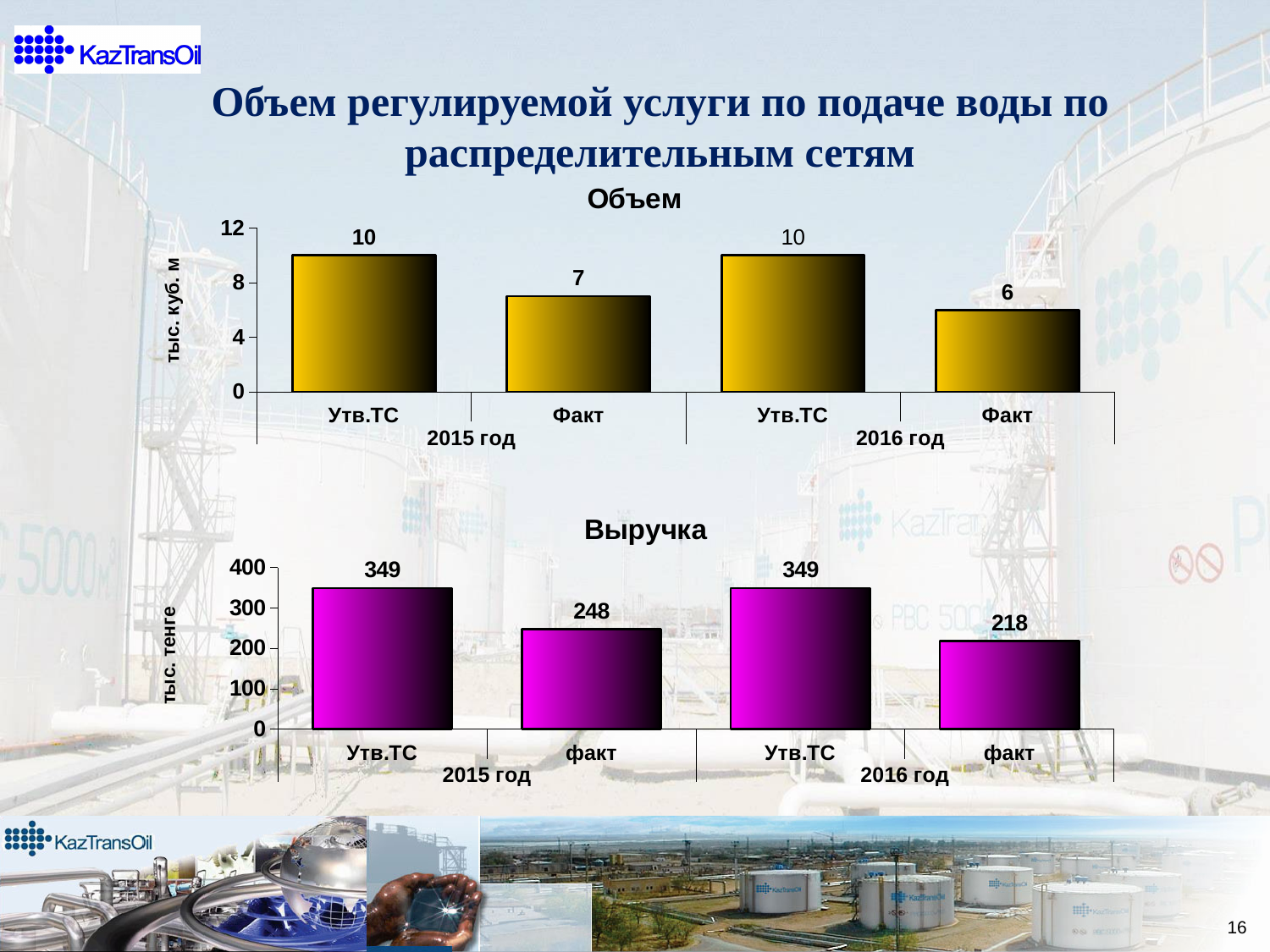
In the "Выручка" chart, what is the difference between Утв.ТС and факт for 2016 год? 131 In the "Объем" chart, what is the value for Утв.ТС in 2016 год? 10 What type of chart is the "Объем" chart? Bar chart How many bars are plotted in the "Выручка" chart? 4 In the "Объем" chart, what is the value for Факт in 2016 год? 6 In the "Объем" chart, what is the value for Факт in 2015 год? 7 In the "Выручка" chart, which is larger: факт for 2015 год or факт for 2016 год? факт 2015 год In the "Выручка" chart, what is the value for факт in 2016 год? 218 In the "Объем" chart, which bar has the lowest value? Факт 2016 год In the "Выручка" chart, what is the value for факт in 2015 год? 248 In the "Выручка" chart, what is the value for Утв.ТС in 2015 год? 349 In the "Объем" chart, what is the difference between Утв.ТС and Факт for 2015 год? 3